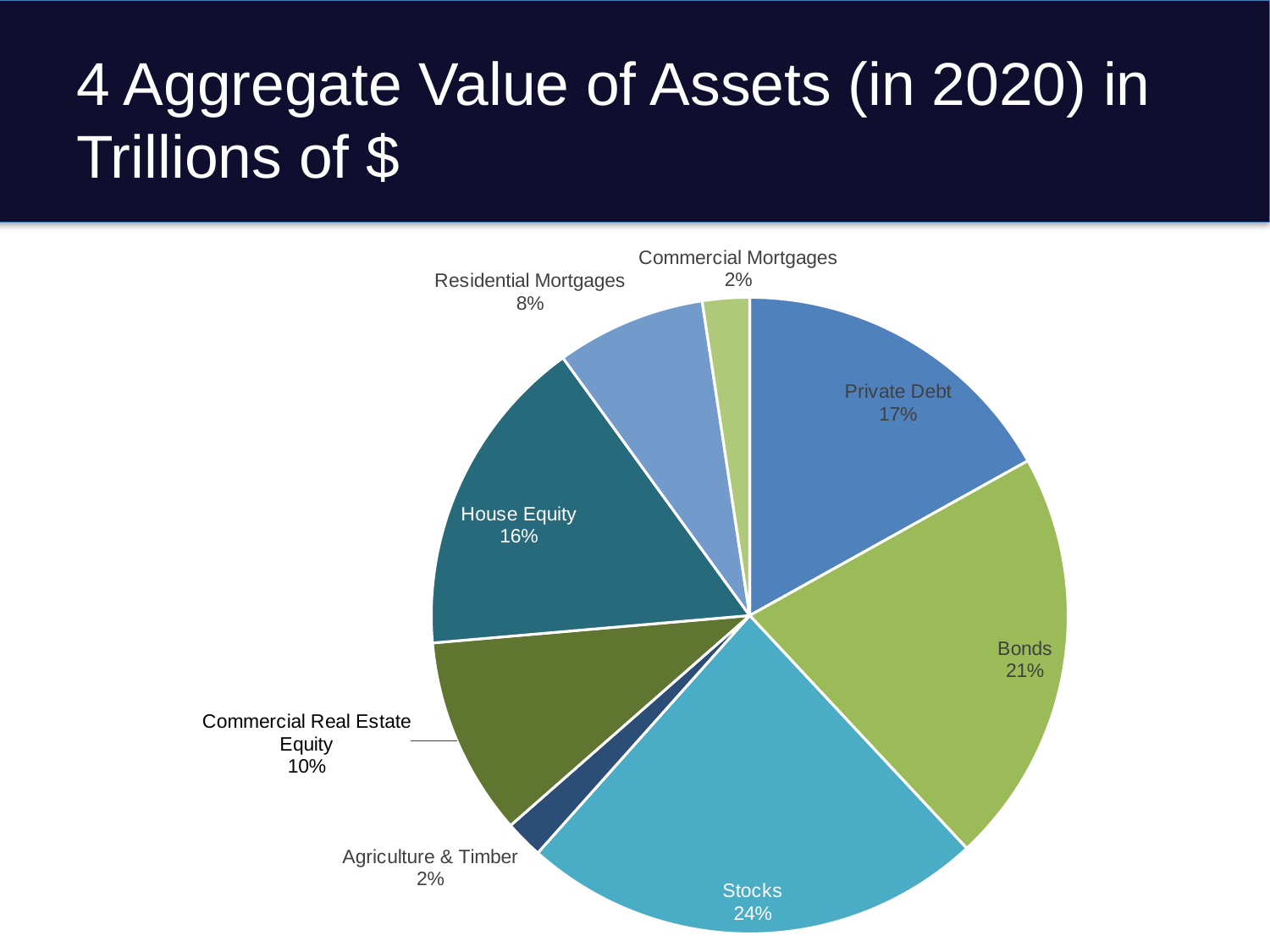
What kind of chart is shown on the slide? pie chart How many slices does the pie chart have? 8 What percentage is shown for Residential Mortgages? 8% What share of the pie does Stocks represent? 24% What is the title of the slide containing the pie chart? 4 Aggregate Value of Assets (in 2020) in Trillions of $ Which category has the largest slice of the pie? Stocks What percentage is shown for House Equity? 16% What percentage is shown for Bonds? 21% What is the difference in percentage points between Stocks and Private Debt? 7 Which is larger, Bonds or House Equity? Bonds What percentage is shown for Commercial Real Estate Equity? 10% What is the difference in percentage points between Private Debt and Residential Mortgages? 9